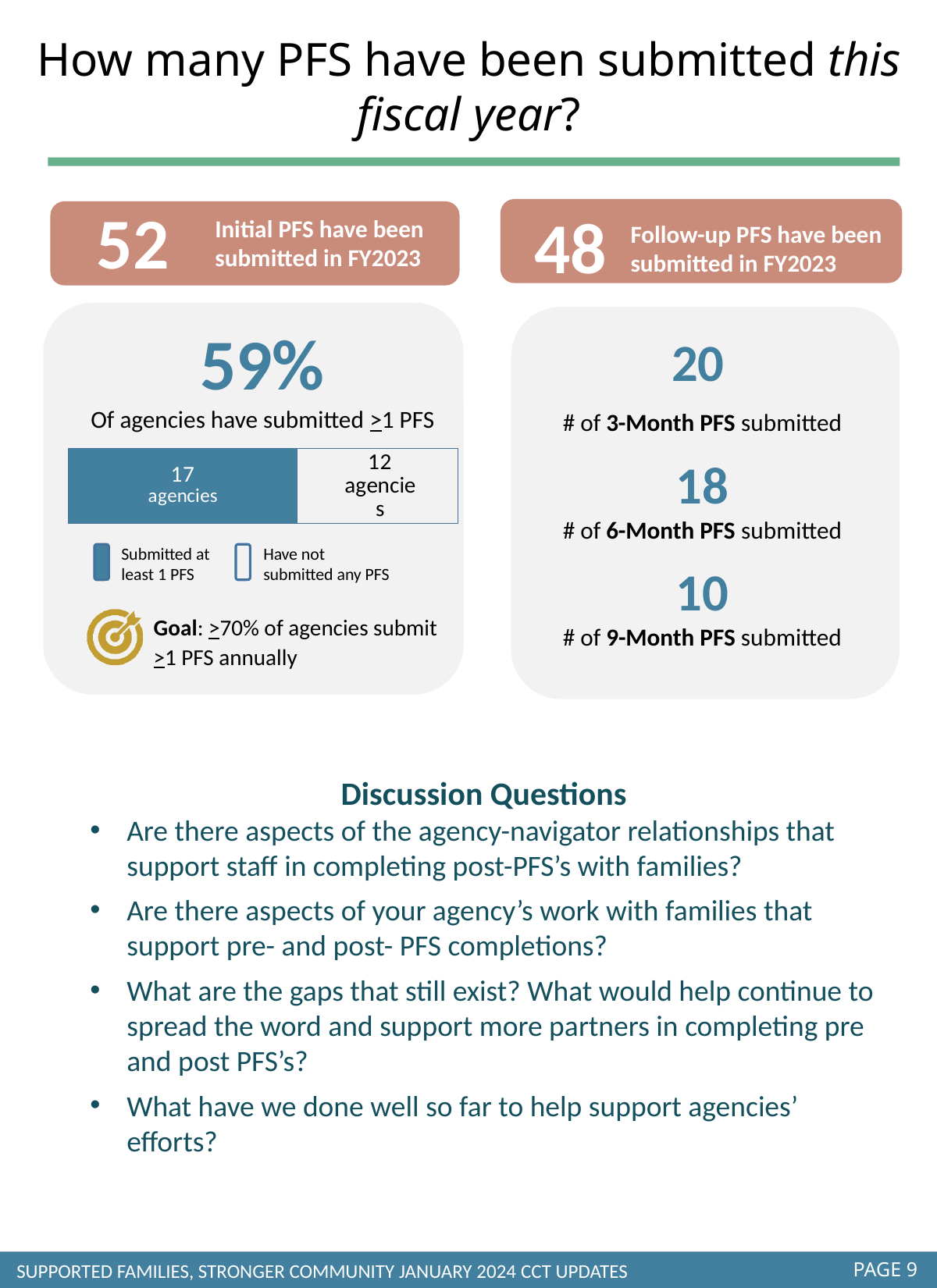
In the stacked bar chart, which segment is the smallest? Have not submitted any PFS What is the total number of agencies represented in the stacked bar chart? 29 What percentage of agencies have submitted at least 1 PFS, according to the figure above the stacked bar chart? 59% What kind of chart is shown on the left side of the slide under the 59% figure? bar chart In the stacked bar chart, which segment is larger: agencies that submitted at least 1 PFS or agencies that have not submitted any PFS? Submitted at least 1 PFS How many series does the legend of the stacked bar chart list? 2 In the stacked bar chart, which legend entry is shown with the white (unfilled) colour? Have not submitted any PFS In the stacked bar chart, what is the difference between the number of agencies that submitted at least 1 PFS and those that have not submitted any PFS? 5 In the stacked bar chart, which legend entry is shown with the dark blue filled colour? Submitted at least 1 PFS In the stacked bar chart, how many agencies have submitted at least 1 PFS? 17 agencies In the stacked bar chart, how many agencies have not submitted any PFS? 12 agencies